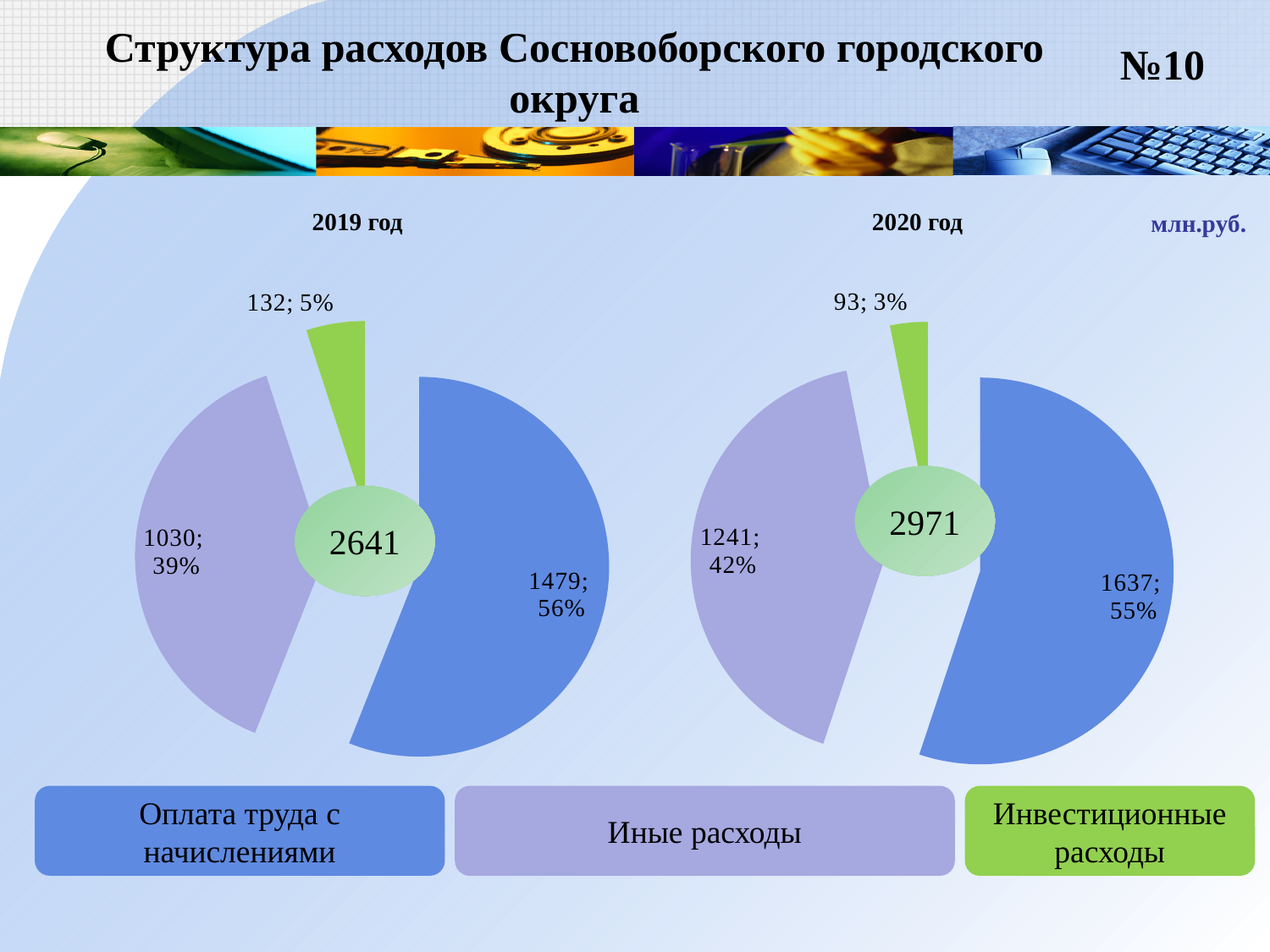
In the 2019 год chart, which category has the largest slice? Оплата труда с начислениями What is the difference between Оплата труда с начислениями in 2020 год and in 2019 год? 158 Which colour represents Инвестиционные расходы in the legend? Green In the 2020 год chart, what is the value for Иные расходы? 1241 In the 2019 год chart, what share of the pie is Иные расходы? 39% In the 2020 год chart, which category has the smallest slice? Инвестиционные расходы What total is shown in the centre of the 2020 год chart? 2971 In the 2019 год chart, what is the value for Оплата труда с начислениями? 1479 How many categories does each pie chart have? 3 In the 2020 год chart, what share of the pie is Инвестиционные расходы? 3% What type of chart is used on this slide? Pie chart Which is larger: Инвестиционные расходы in 2019 год or in 2020 год? 2019 год